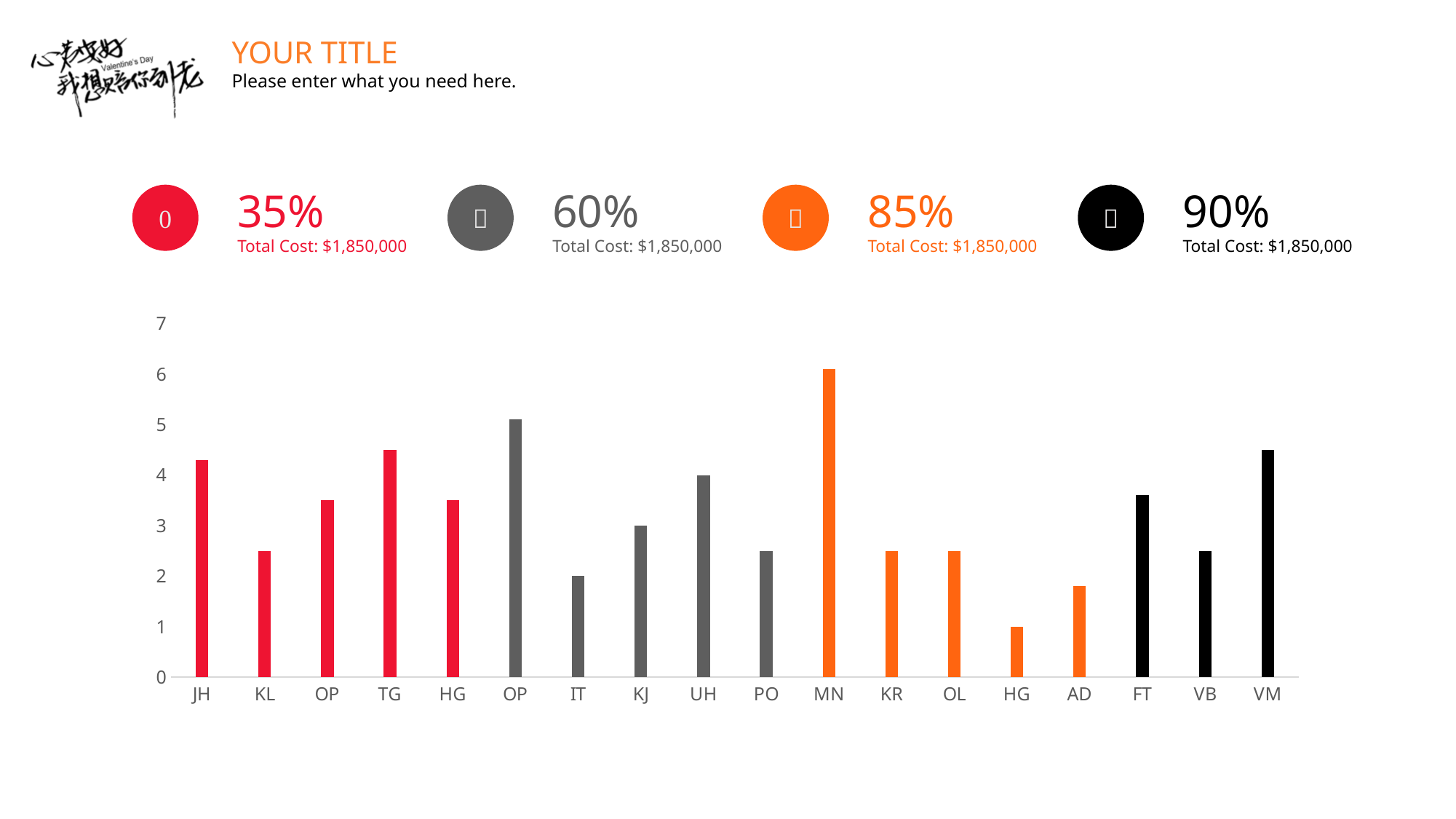
Is the value for JH greater or less than 4? greater Is the value for MN greater or less than 5? greater What is the value for KJ in the chart? 3 What is the value for IT in the chart? 2 Which is larger, the value for FT or the value for VB? FT Which category has the lowest bar in the chart? HG Is the value for AD greater or less than 2? less What kind of chart is shown on the slide? bar chart Which category has the highest bar in the chart? MN What is the value for UH in the chart? 4 How many categories are shown on the x axis of the chart? 18 What is the highest value shown on the vertical axis of the chart? 7